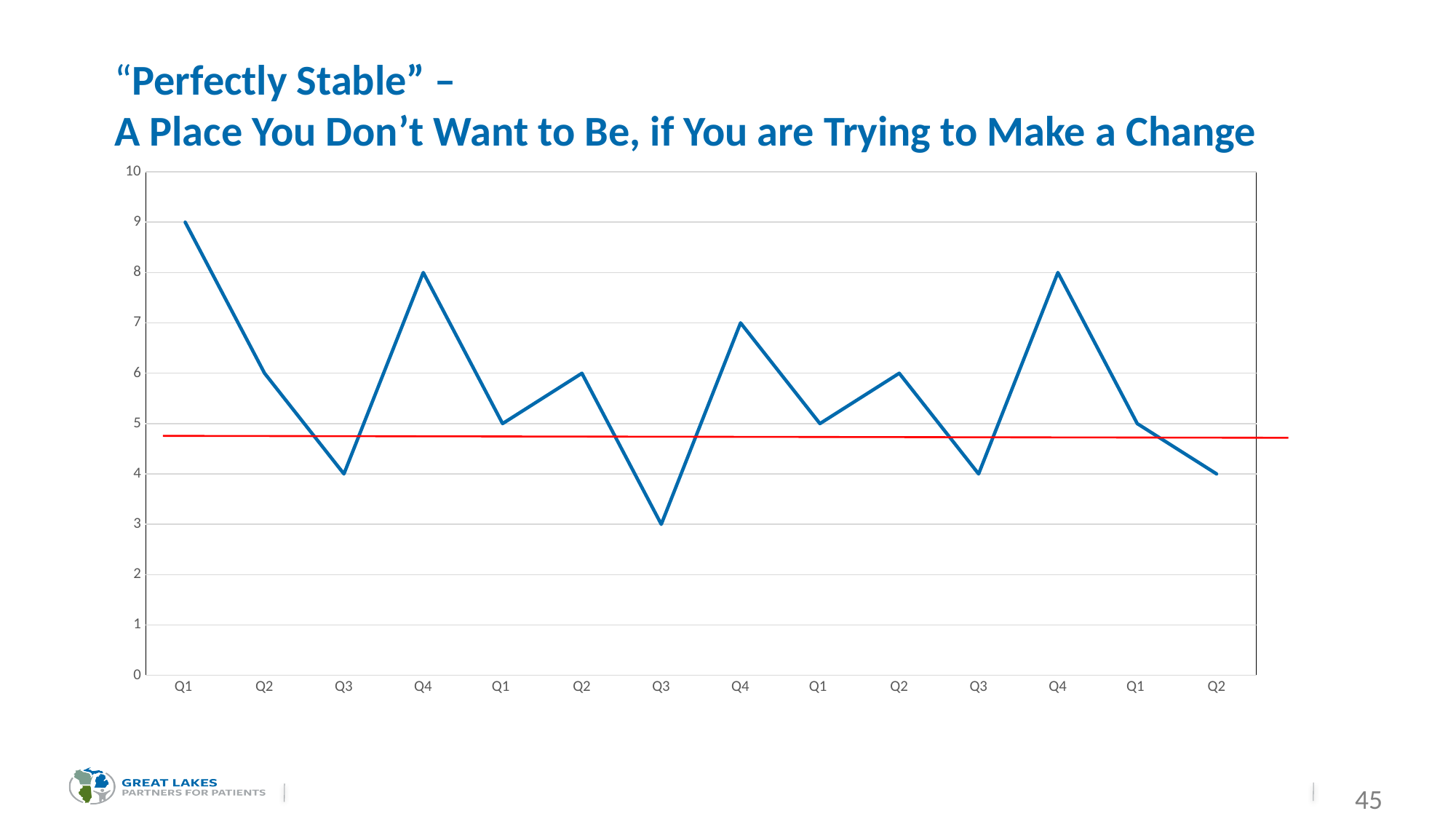
Is the value of the red line greater or less than 5? less What is the value at the last point (the rightmost Q2) on the blue line? 4 What is the value at the second Q3 point (the seventh point from the left) on the blue line? 3 What is the highest value shown on the vertical axis? 10 What is the value at the first Q3 point (the third point from the left) on the blue line? 4 Which point on the blue line has the highest value? the first Q1 (leftmost point) Which is larger on the blue line: the first Q4 point (fourth from the left) or the second Q4 point (eighth from the left)? the first Q4 point Which point on the blue line has the lowest value? the second Q3 (seventh point from the left) How many data points are plotted on the blue line? 14 What is the value at the first Q1 point (the leftmost point) on the blue line? 9 What kind of chart is shown on the slide? line chart What is the difference between the leftmost point (first Q1) and the lowest point (second Q3) on the blue line? 6